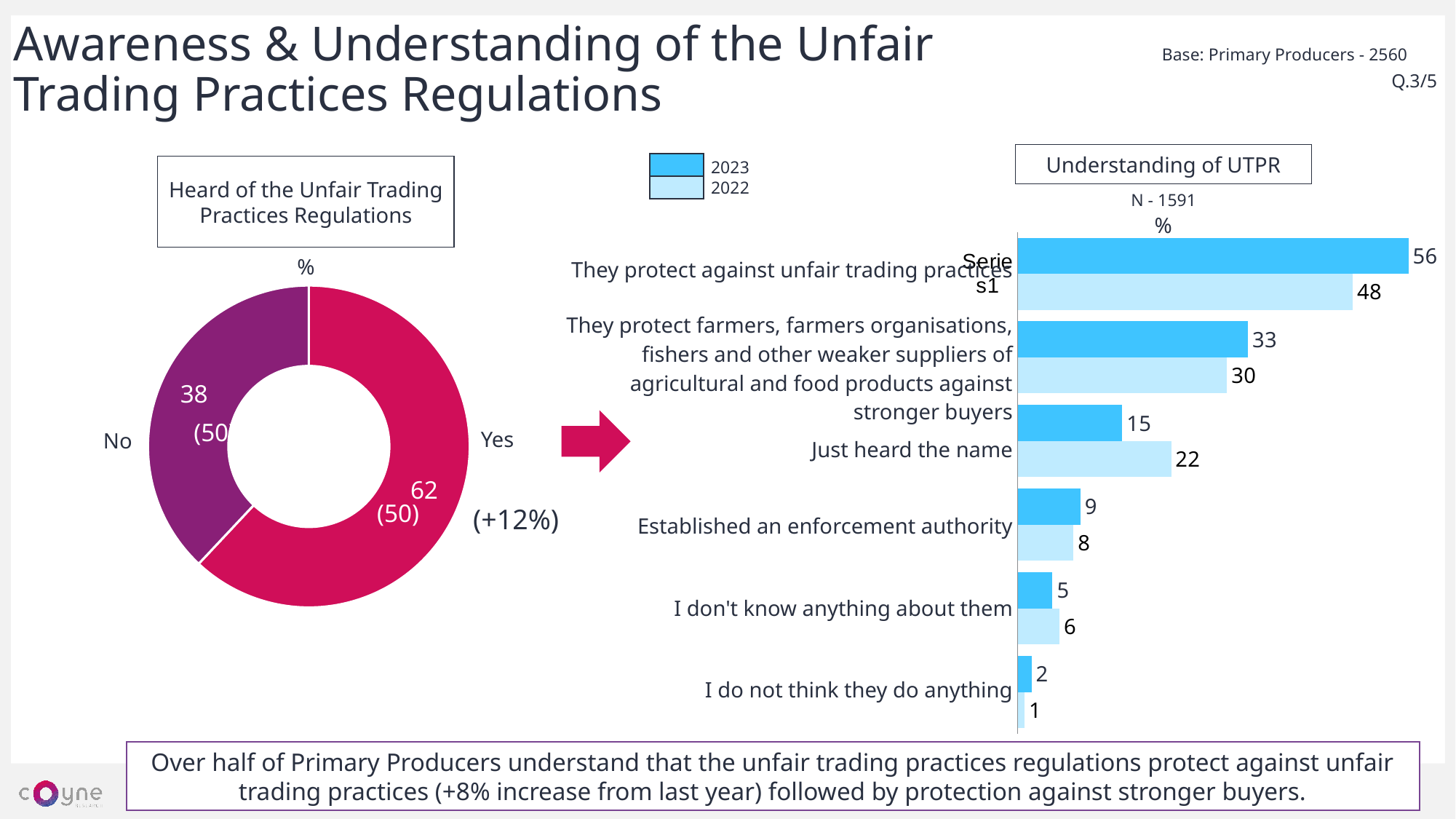
In the 'Understanding of UTPR' chart, what is the 2023 value for 'They protect against unfair trading practices'? 56 In the 'Understanding of UTPR' chart, how many series does the legend list? 2 In the 'Heard of the Unfair Trading Practices Regulations' chart, what percentage answered No? 38 In the 'Understanding of UTPR' chart, how many categories are shown? 6 In the 'Heard of the Unfair Trading Practices Regulations' chart, what percentage answered Yes? 62 In the 'Understanding of UTPR' chart, what is the 2022 value for 'Just heard the name'? 22 In the 'Understanding of UTPR' chart, what is the difference between the 2023 and 2022 values for 'They protect against unfair trading practices'? 8 In the 'Heard of the Unfair Trading Practices Regulations' chart, what is the difference between the Yes and No percentages? 24 In the 'Understanding of UTPR' chart, which category has the lowest 2022 value? I do not think they do anything In the 'Understanding of UTPR' chart, is the 2023 value for 'Just heard the name' larger or smaller than the 2022 value? Smaller In the 'Understanding of UTPR' chart, which category has the highest 2023 value? They protect against unfair trading practices What kind of chart is the 'Heard of the Unfair Trading Practices Regulations' chart? Donut (pie) chart